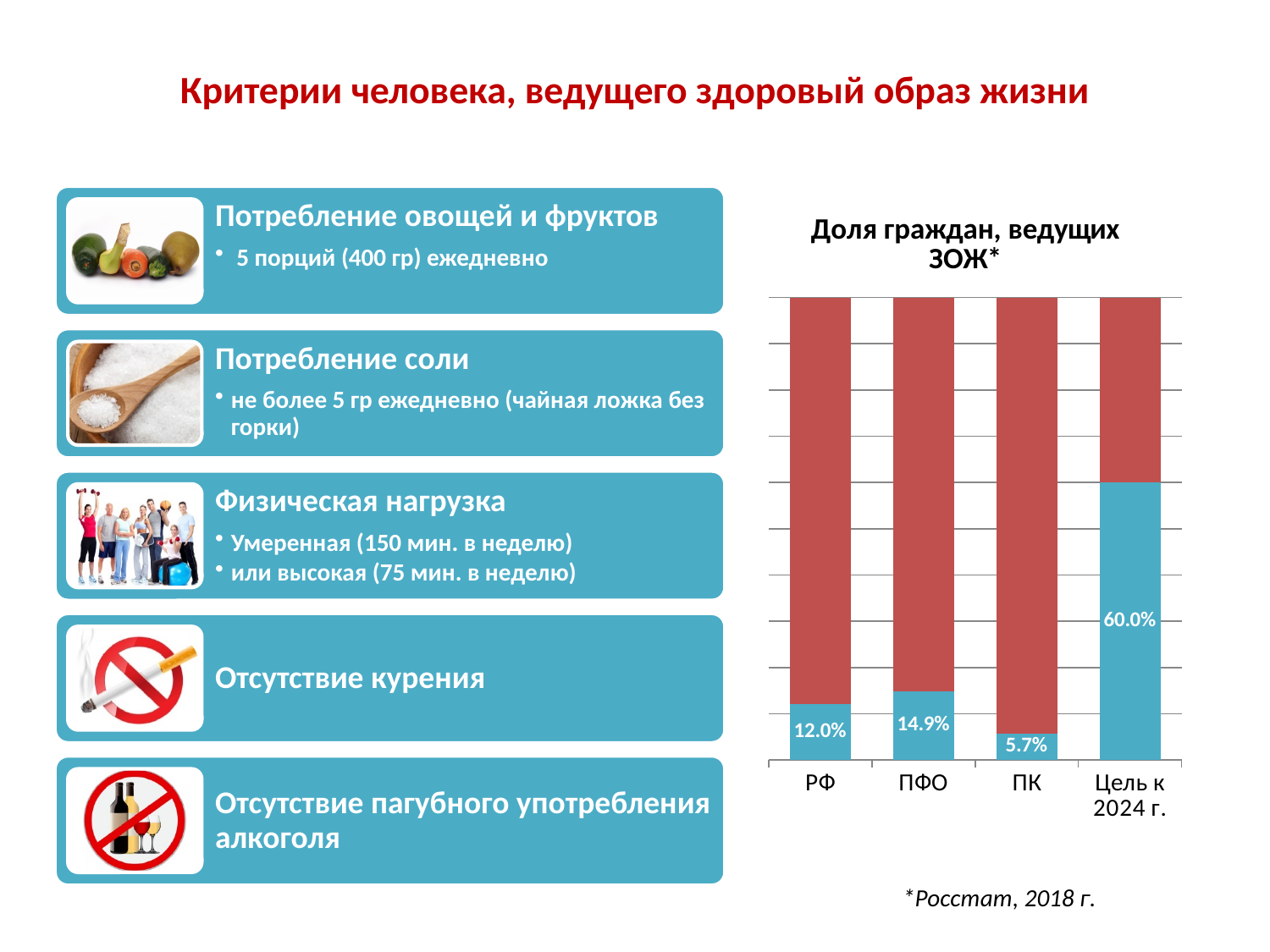
Which category has the lowest labelled value in the chart? ПК What is the value shown for ПК in the chart? 5.7% How many categories are shown on the x axis of the chart? 4 Which category has the highest labelled value in the chart? Цель к 2024 г. What is the value shown for РФ in the chart "Доля граждан, ведущих ЗОЖ*"? 12.0% What is the value shown for ПФО in the chart? 14.9% What is the title of the chart on the slide? Доля граждан, ведущих ЗОЖ* Which is larger, the value for РФ or the value for ПФО? ПФО What is the difference between the values for ПФО and РФ? 2.9% What is the difference between the value for "Цель к 2024 г." and the value for ПК? 54.3% What kind of chart is shown on the slide? Bar chart What is the value shown for "Цель к 2024 г." in the chart? 60.0%